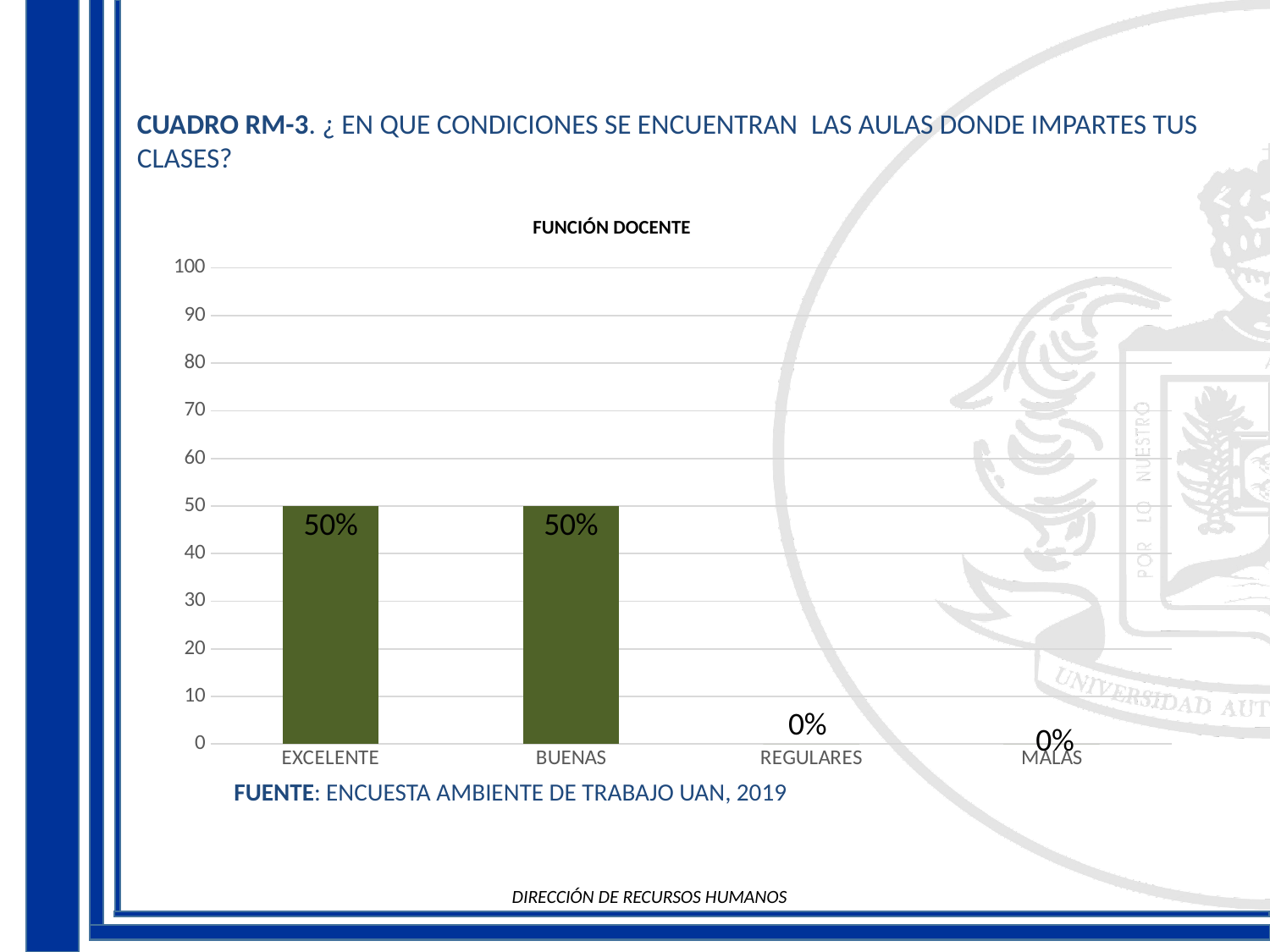
What is the value for EXCELENTE? 50% What is the maximum value shown on the y axis? 100 Is the value for EXCELENTE greater or less than 40? greater What kind of chart is shown on the slide? bar chart How many categories are shown on the x axis? 4 Do the values rise or fall from EXCELENTE to MALAS along the x axis? fall What is the difference between the values for EXCELENTE and REGULARES? 50% What is the value for BUENAS? 50% Which is larger, the value for BUENAS or the value for MALAS? BUENAS What is the value for MALAS? 0% What is the title of the chart? FUNCIÓN DOCENTE What is the value for REGULARES? 0%